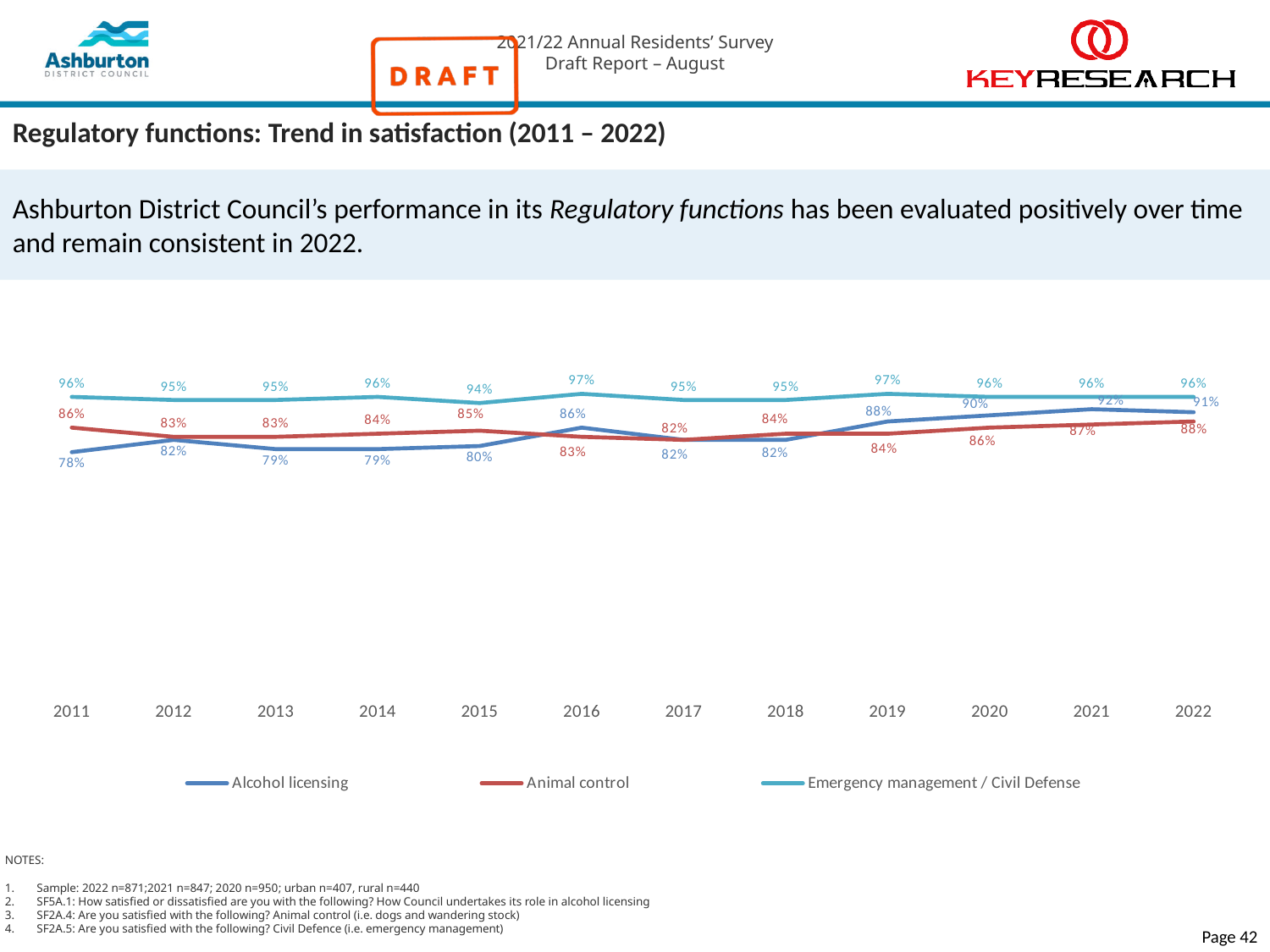
What is the highest value reached by the Emergency management / Civil Defense line? 97% How many series does the legend list? 3 What is the satisfaction value for Animal control in 2022? 88% In 2022, which is higher: Alcohol licensing or Animal control? Alcohol licensing What is the satisfaction value for Alcohol licensing in 2022? 91% What is the satisfaction value for Alcohol licensing in 2011? 78% What type of chart is shown on the slide? Line chart By how many percentage points did Alcohol licensing satisfaction change from 2011 to 2022? 13 percentage points In which year is the Alcohol licensing value lowest? 2011 How many years are plotted along the x axis? 12 Does the Alcohol licensing line rise or fall between 2018 and 2021? Rise What is the satisfaction value for Emergency management / Civil Defense in 2022? 96%